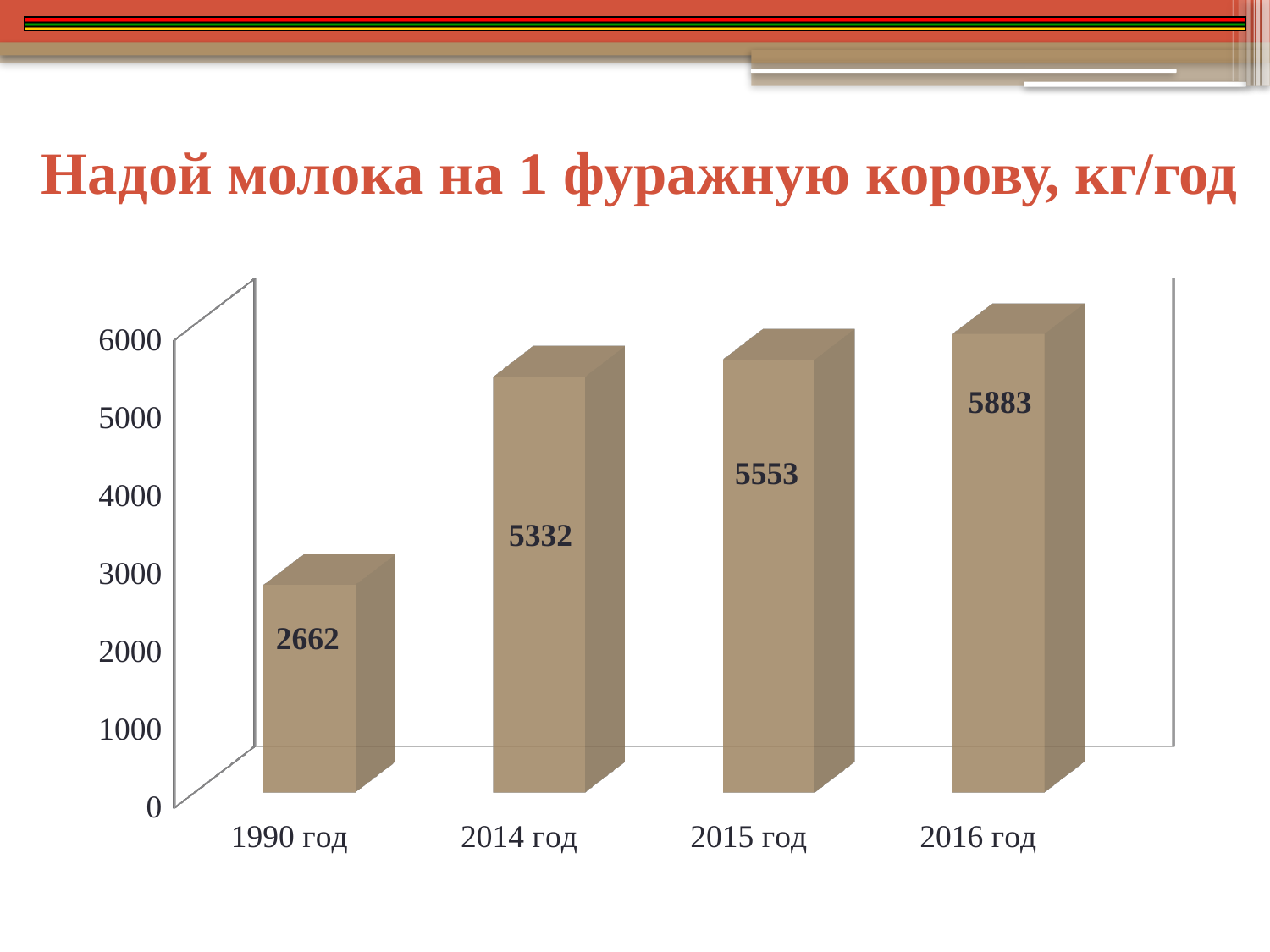
What is the difference in milk yield between 2015 год and 2014 год? 221 What kind of chart is shown on the slide? Bar chart Which year has the lowest milk yield per forage cow? 1990 год What is the difference in milk yield between 2016 год and 1990 год? 3221 What is the milk yield per forage cow for 2016 год? 5883 What is the milk yield per forage cow for 2014 год? 5332 What is the milk yield per forage cow for 1990 год? 2662 How many years are shown on the chart? 4 Which year has the highest milk yield per forage cow? 2016 год What is the milk yield per forage cow for 2015 год? 5553 Which year has a larger milk yield, 2014 год or 2015 год? 2015 год Do the milk yield values rise or fall from 1990 год to 2016 год? Rise